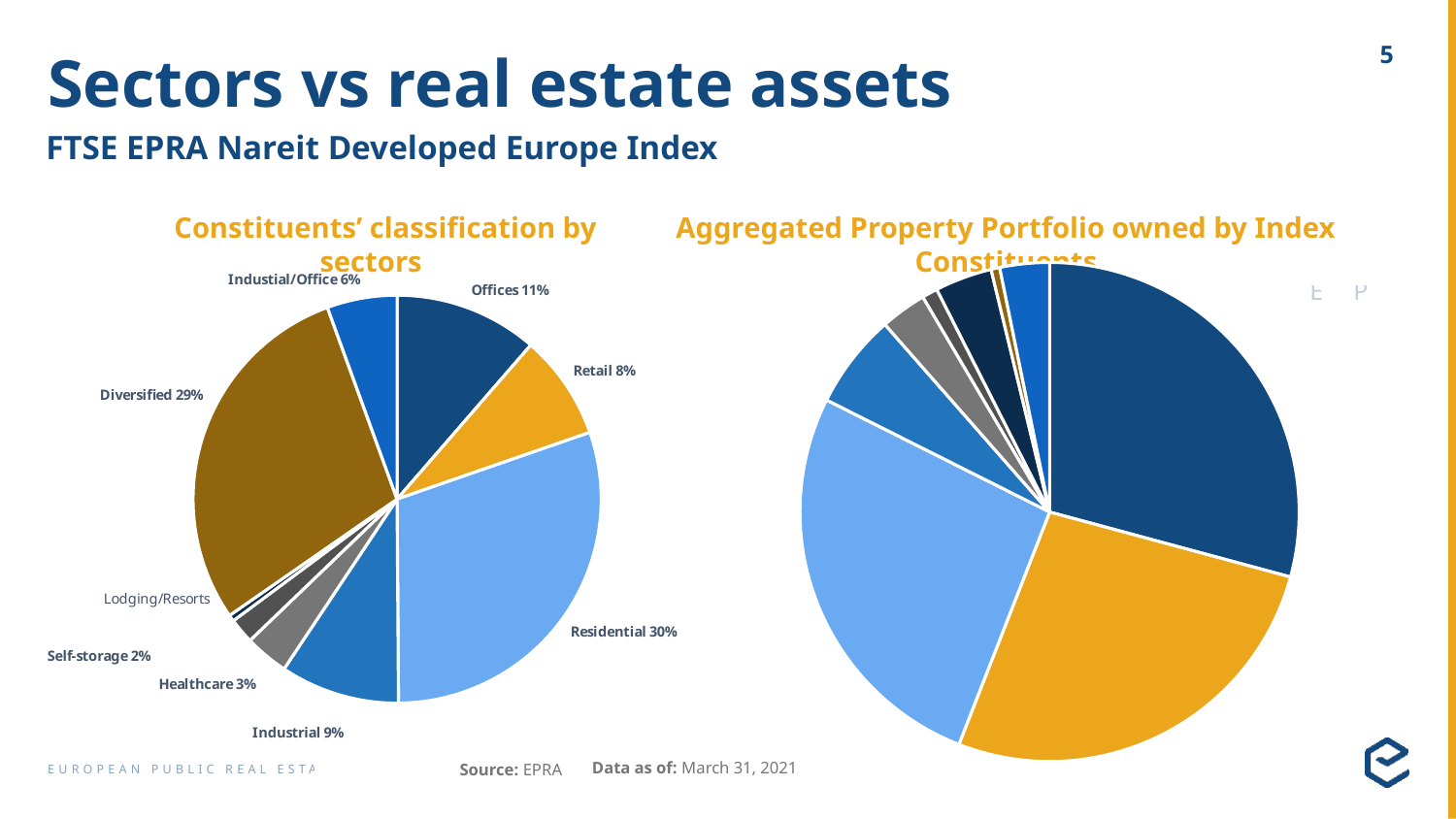
What is the title of the chart on the left of the slide? Constituents' classification by sectors In the 'Constituents' classification by sectors' pie chart, what share is Offices? 11% How many sector categories are shown in the 'Constituents' classification by sectors' pie chart? 9 In the 'Constituents' classification by sectors' pie chart, which is larger, Retail or Self-storage? Retail In the 'Constituents' classification by sectors' pie chart, which is larger, Diversified or Industrial? Diversified In the 'Constituents' classification by sectors' pie chart, what share is Industrial/Office? 6% What type of chart is the 'Aggregated Property Portfolio owned by Index Constituents' chart on the right? Pie chart In the 'Constituents' classification by sectors' pie chart, what share is Residential? 30% In the 'Constituents' classification by sectors' pie chart, which sector has the largest share? Residential In the 'Constituents' classification by sectors' pie chart, what share is Diversified? 29% In the 'Constituents' classification by sectors' pie chart, what share is Healthcare? 3% In the 'Constituents' classification by sectors' pie chart, what is the difference in percentage points between Residential and Offices? 19 percentage points